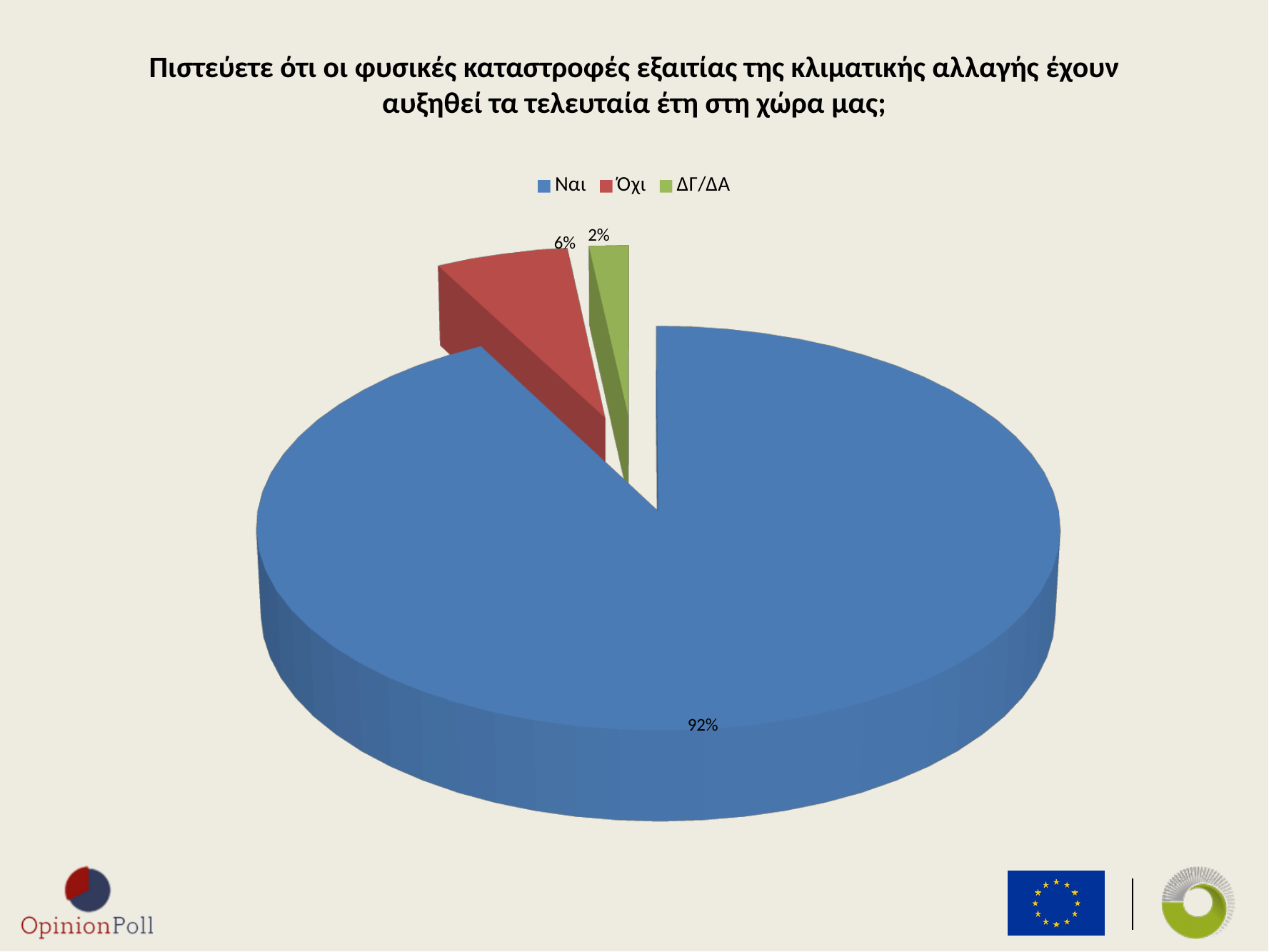
How many entries does the legend list? 3 What percentage of respondents answered ΔΓ/ΔΑ? 2% Which is larger, the share for Όχι or the share for ΔΓ/ΔΑ? Όχι What is the difference in percentage points between Όχι and ΔΓ/ΔΑ? 4 How many slices does the pie chart have? 3 What kind of chart is shown on the slide? Pie chart What percentage of respondents answered Όχι? 6% Which response has the smallest share of the pie? ΔΓ/ΔΑ What percentage of respondents answered Ναι? 92% Which response has the largest share of the pie? Ναι What is the difference in percentage points between Ναι and Όχι? 86 What colour is the slice for Όχι? Red